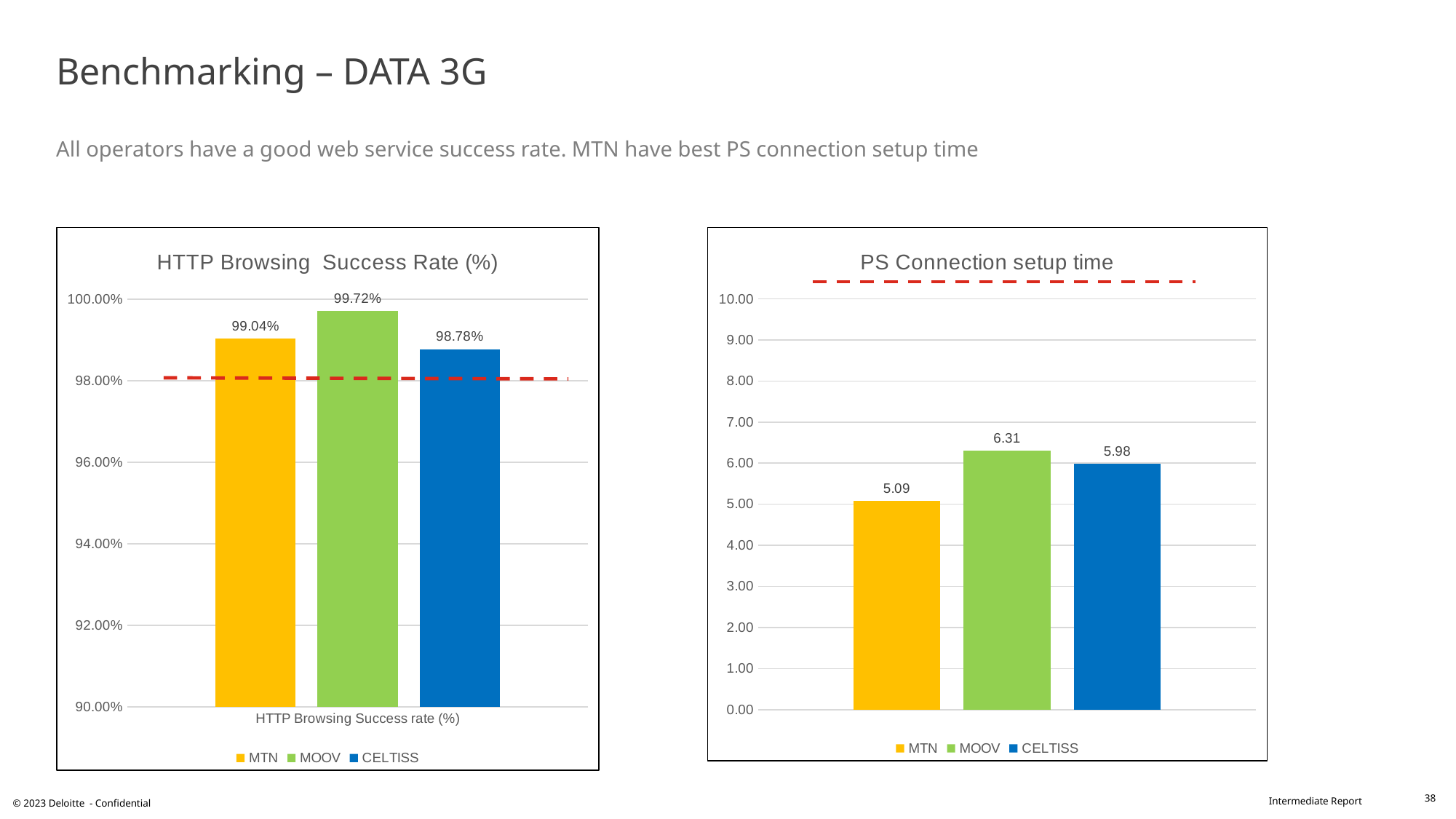
In the HTTP Browsing Success Rate (%) chart, what is the value for MOOV? 99.72% In the HTTP Browsing Success Rate (%) chart, what is the value for CELTISS? 98.78% In the PS Connection setup time chart, what is the difference between the MOOV and CELTISS values? 0.33 In the PS Connection setup time chart, is the value for CELTISS greater or less than 5.00? greater In the PS Connection setup time chart, what is the value for MOOV? 6.31 In the HTTP Browsing Success Rate (%) chart, which operator has the highest success rate? MOOV In the HTTP Browsing Success Rate (%) chart, which operator has the lowest success rate? CELTISS In the HTTP Browsing Success Rate (%) chart, what is the difference between the MOOV and MTN values? 0.68% In the PS Connection setup time chart, which operator has the lowest setup time? MTN How many series does the legend of the PS Connection setup time chart list? 3 In the PS Connection setup time chart, what is the value for MTN? 5.09 In the PS Connection setup time chart, which operator has the highest setup time? MOOV